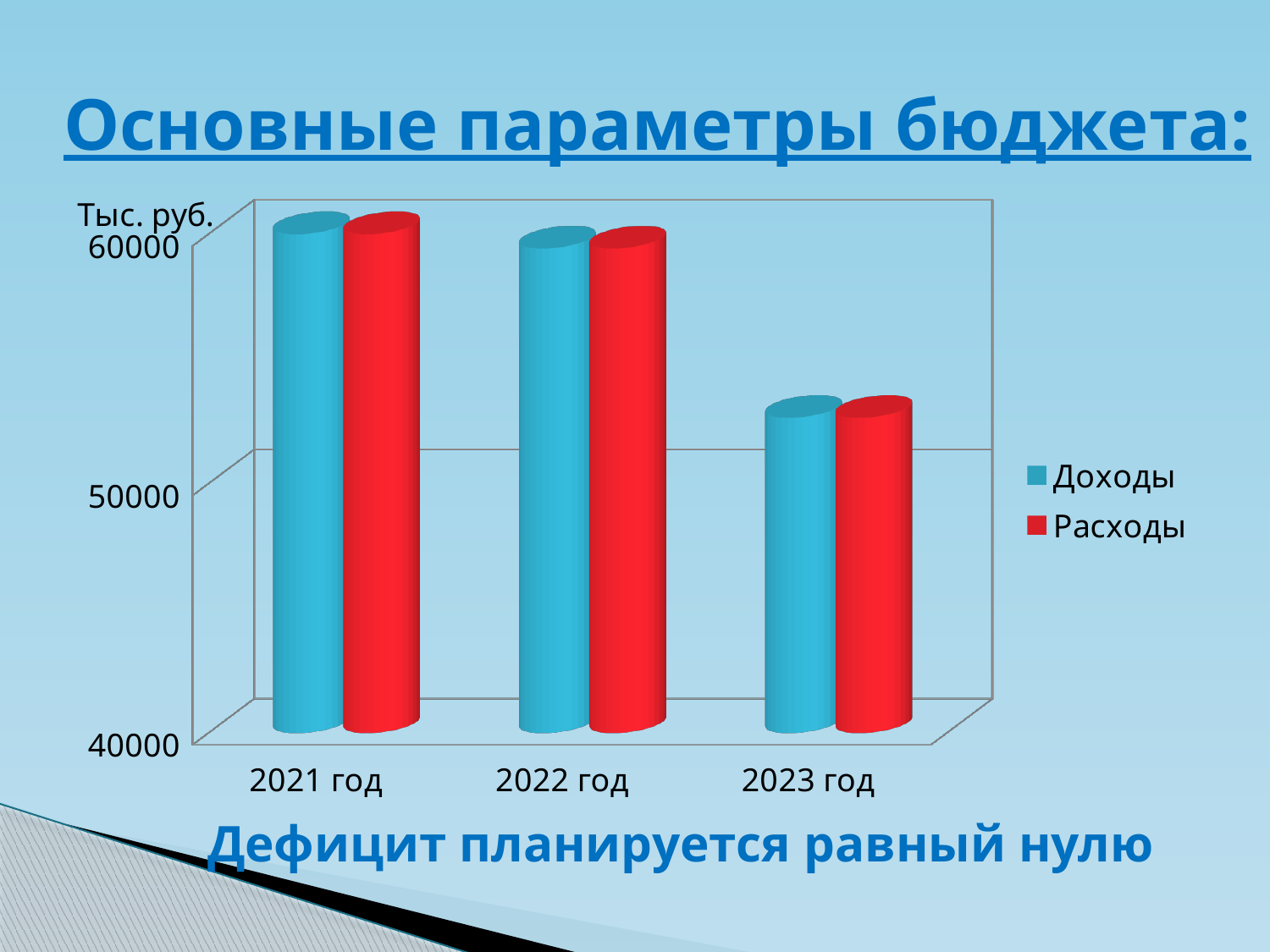
Which is larger: Расходы in 2021 год or Расходы in 2023 год? Расходы in 2021 год Is the value for Доходы in 2023 год greater or less than 50000? greater How many year categories are shown on the x axis of the chart? 3 Do the Доходы values rise or fall from 2021 год to 2023 год? fall Which year has the lowest value for Доходы? 2023 год What kind of chart is shown on the slide? Bar chart Is the value for Расходы in 2023 год greater or less than 60000? less Is the value for Доходы in 2021 год greater or less than 50000? greater What unit label is shown above the vertical axis of the chart? Тыс. руб. What is the title of the slide containing the chart? Основные параметры бюджета: Which year has the lowest value for Расходы? 2023 год How many series does the chart legend list? 2